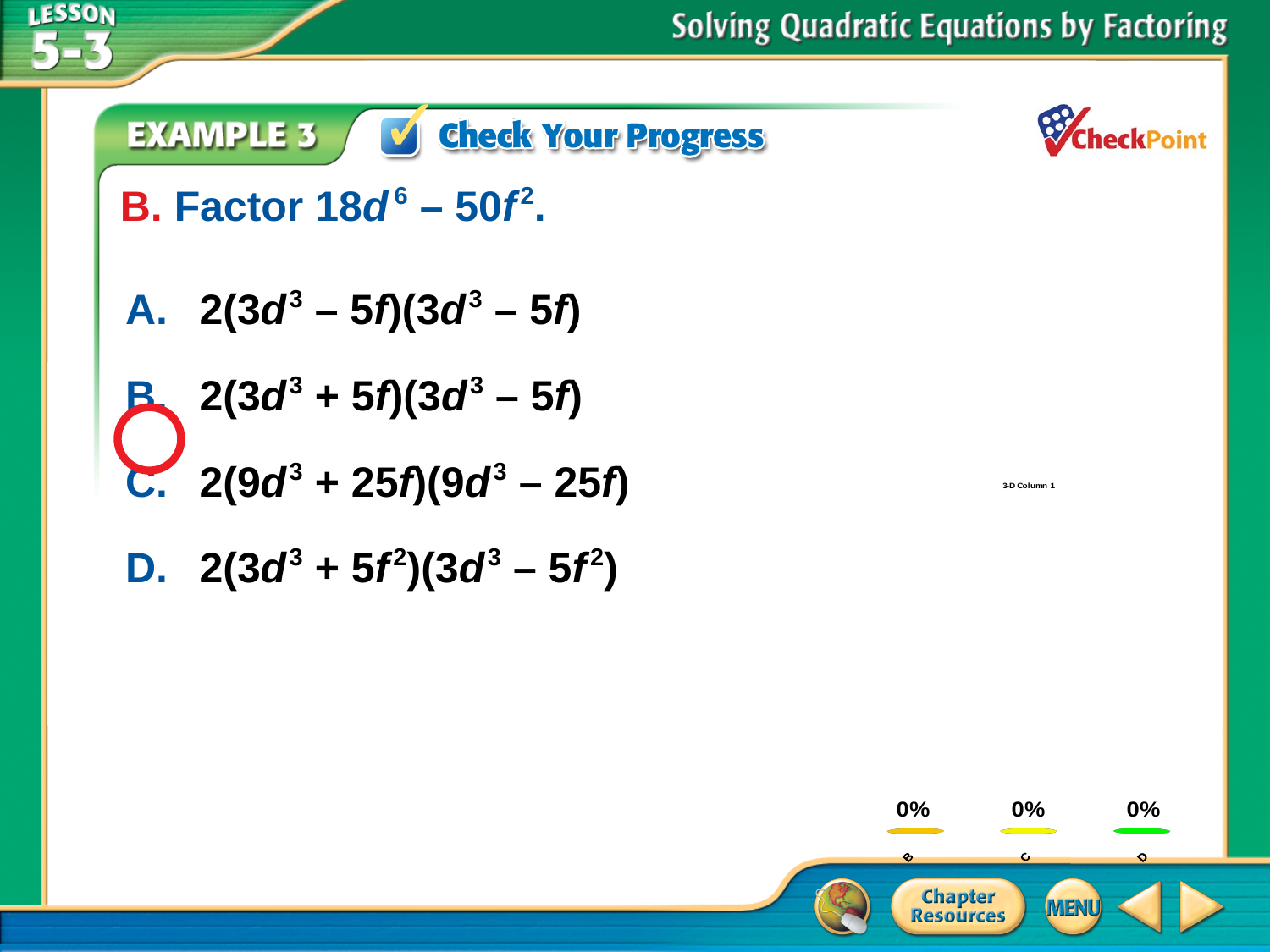
What is the value shown for category C in the chart at the bottom right of the slide? 0% What is the value shown for category D in the chart at the bottom right of the slide? 0% What kind of chart is shown at the bottom right of the slide? bar chart How many categories are plotted in the chart at the bottom right of the slide? 3 What is the value shown for category B in the chart at the bottom right of the slide? 0% What is the difference between the values for B and D in the chart at the bottom right of the slide? 0% Do the values rise, fall, or stay the same from B to D in the chart at the bottom right of the slide? stay the same What colour is the bar for category D in the chart at the bottom right of the slide? green